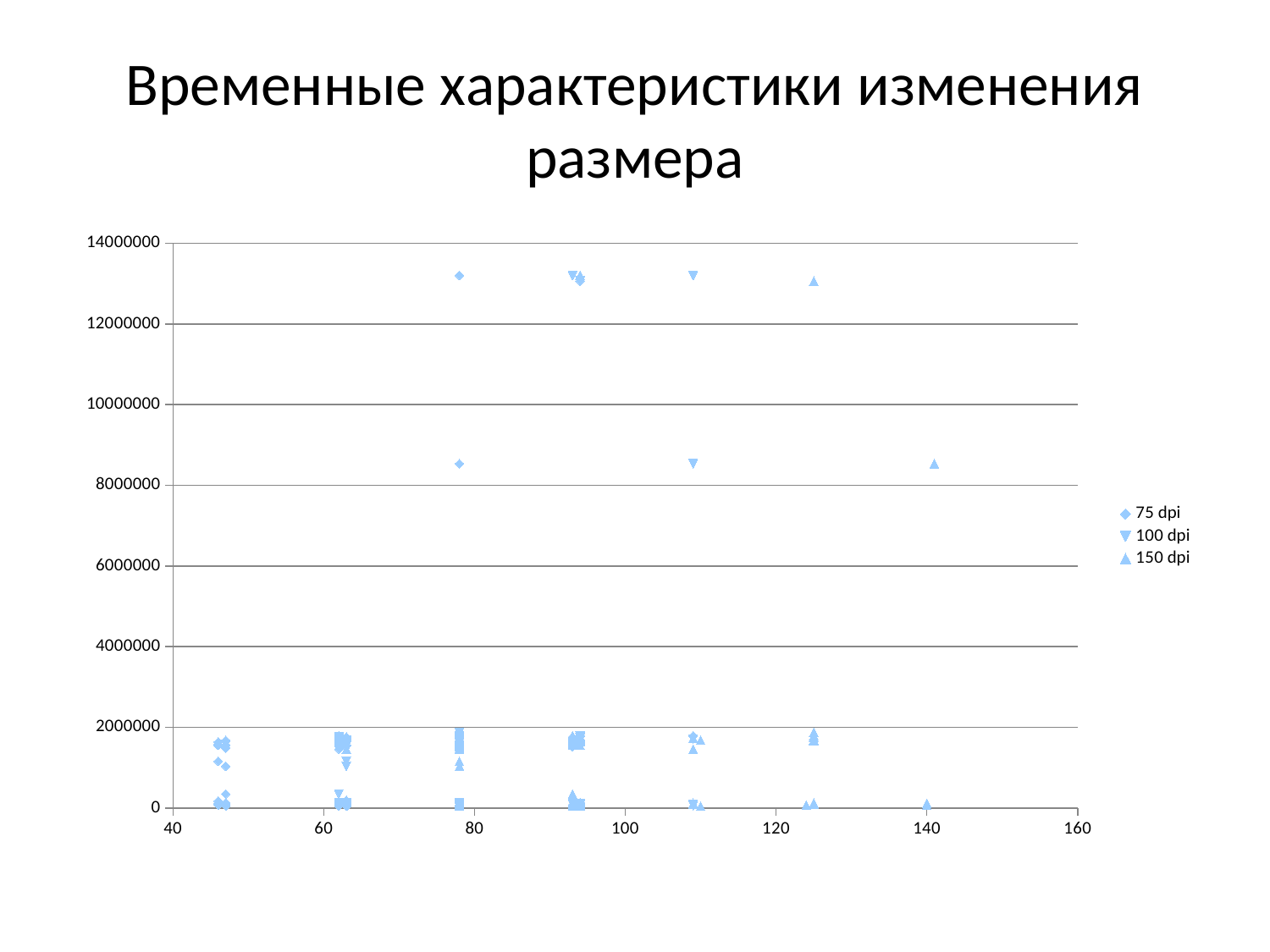
Are the 75 dpi points plotted near x = 47 greater or less than 2000000? less Is the 150 dpi point plotted near x = 140 greater or less than 8000000? greater What is the highest value shown on the y axis? 14000000 Is the highest plotted value on the chart greater or less than 12000000? greater How many series does the legend list? 3 What are the series names listed in the legend? 75 dpi, 100 dpi, 150 dpi What is the title of the chart? Временные характеристики изменения размера What kind of chart is shown on the slide? scatter chart